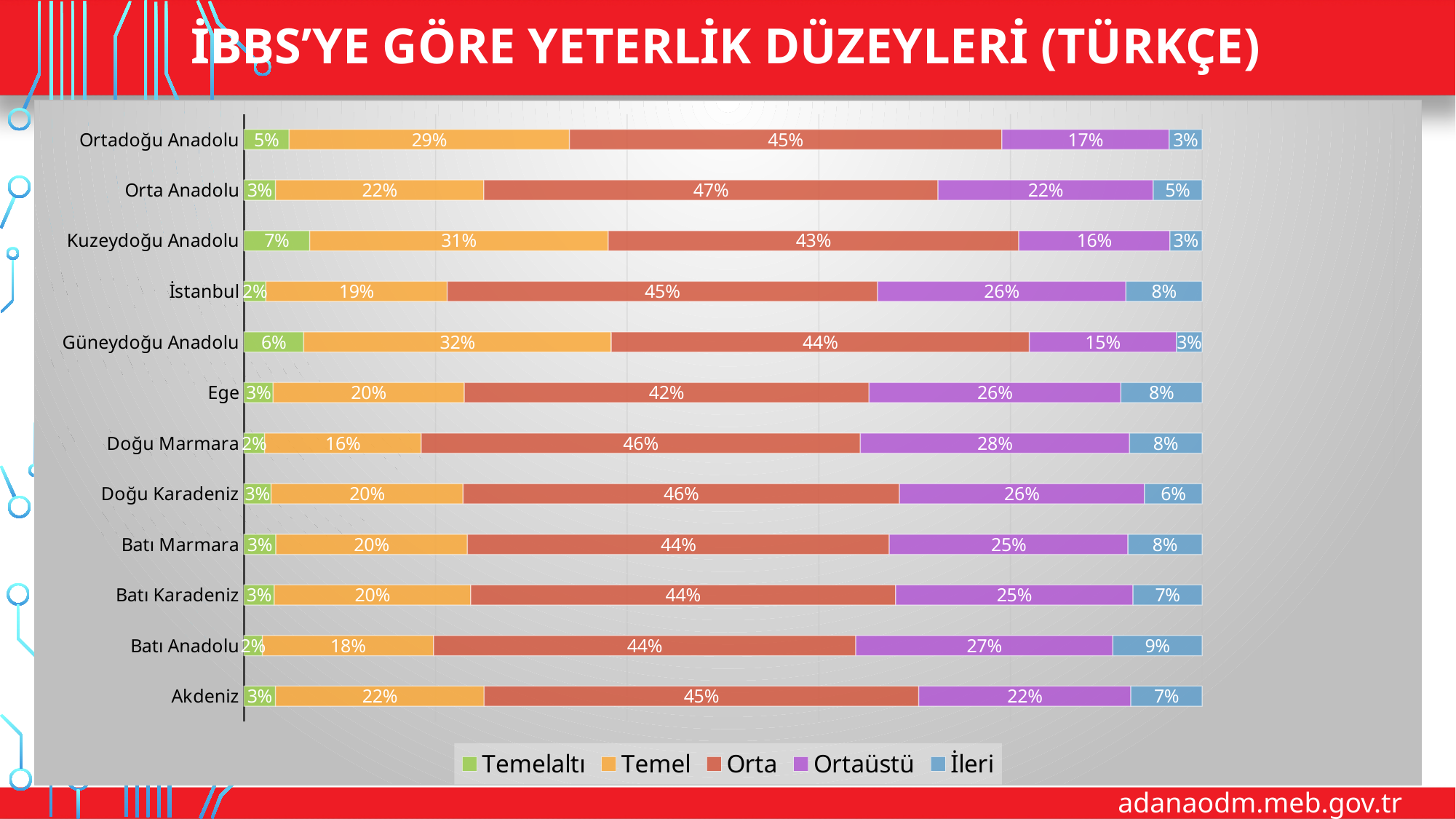
Which series is shown in green in the legend? Temelaltı Which region has the lowest Temel value? Doğu Marmara How many regions (categories) are shown in the chart? 12 How many series does the legend list? 5 Which is larger: the Temel value for Kuzeydoğu Anadolu or the Temel value for Akdeniz? Kuzeydoğu Anadolu Which region has the highest Temelaltı value? Kuzeydoğu Anadolu What is the Orta value for Orta Anadolu? 47% What is the difference between the Ortaüstü values of İstanbul and Ortadoğu Anadolu? 9% What type of chart is shown on the slide? Stacked bar chart What is the Temel value for Güneydoğu Anadolu? 32% Which region has the highest Ortaüstü value? Doğu Marmara What is the İleri value for Batı Anadolu? 9%